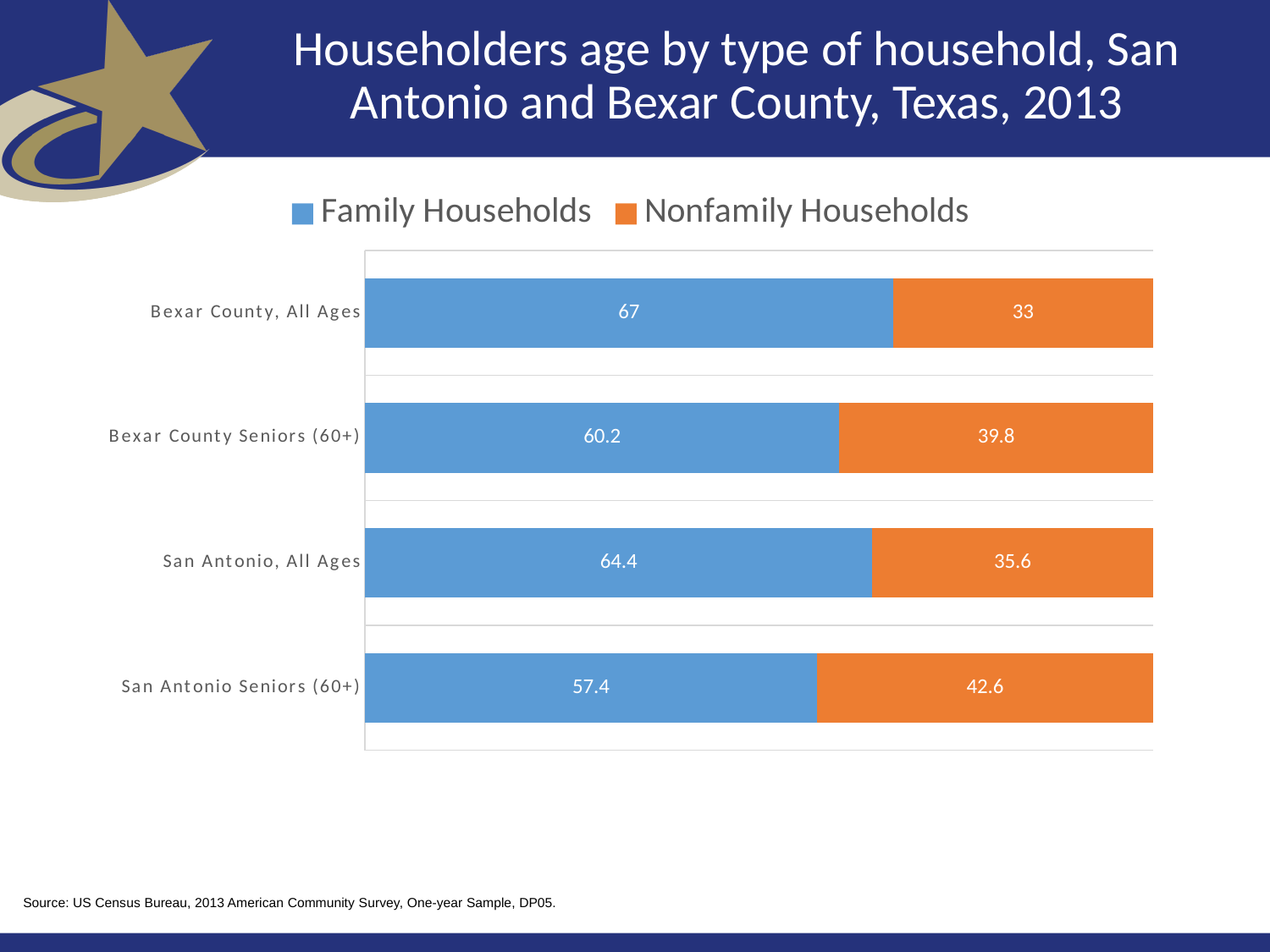
How many categories are shown on the chart? 4 What is the Family Households value for Bexar County, All Ages? 67 What is the Nonfamily Households value for San Antonio Seniors (60+)? 42.6 Which category has the highest Family Households value? Bexar County, All Ages Which is larger: the Nonfamily Households value for San Antonio, All Ages or for Bexar County Seniors (60+)? Bexar County Seniors (60+) What kind of chart is shown on the slide? Stacked bar chart What is the Nonfamily Households value for Bexar County Seniors (60+)? 39.8 What is the difference between the Family Households values for Bexar County, All Ages and San Antonio Seniors (60+)? 9.6 Which category has the lowest Family Households value? San Antonio Seniors (60+) Which category has the highest Nonfamily Households value? San Antonio Seniors (60+) What is the Family Households value for San Antonio, All Ages? 64.4 How many series does the legend list? 2